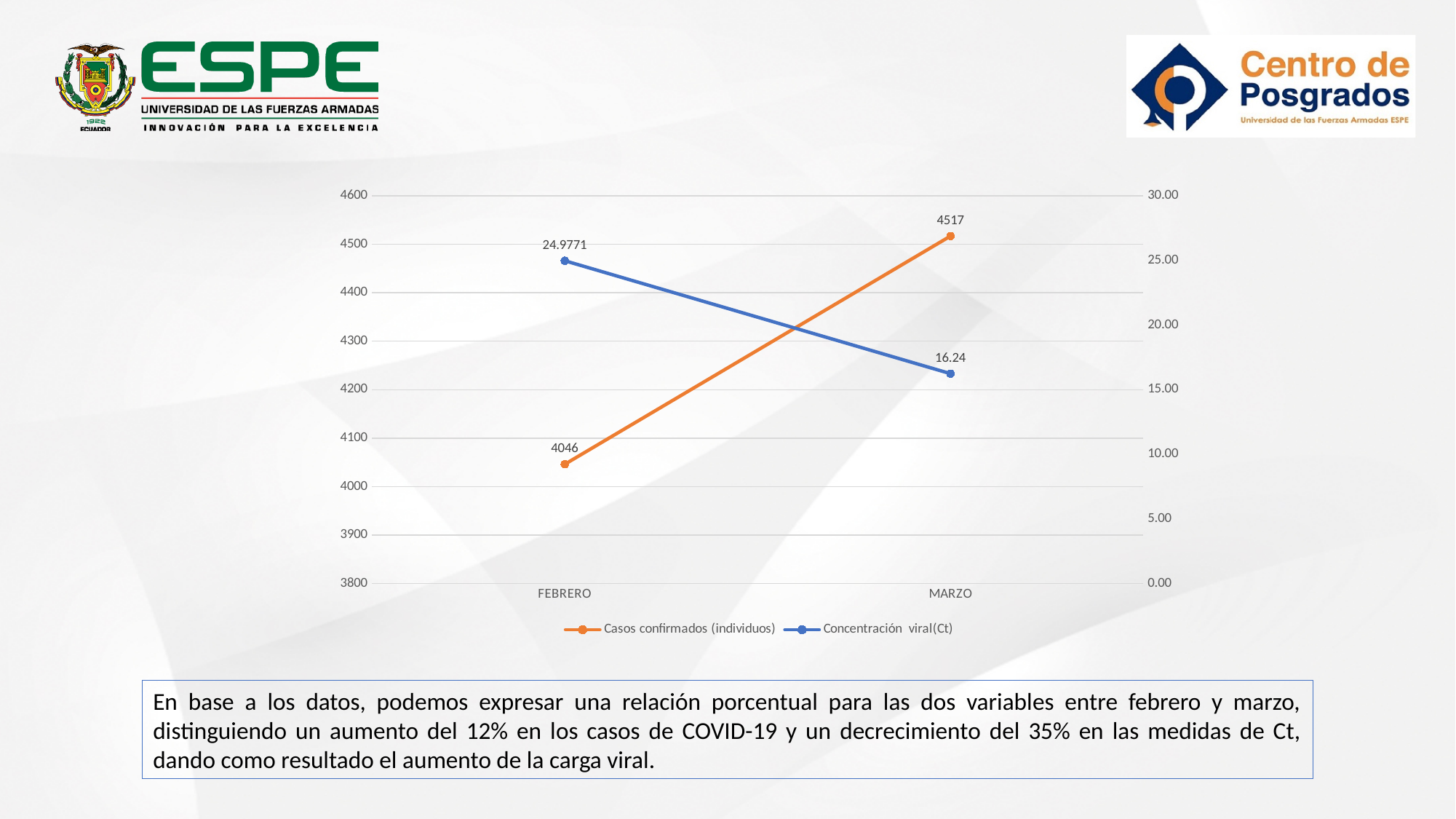
What is the value of Casos confirmados (individuos) for MARZO? 4517 Does the Concentración viral(Ct) series rise or fall from FEBRERO to MARZO? fall Is the Concentración viral(Ct) value for FEBRERO greater or less than the value for MARZO? greater What kind of chart is shown on the slide? line chart Which month has the lower value for Concentración viral(Ct)? MARZO What is the value of Casos confirmados (individuos) for FEBRERO? 4046 Which month has the higher value for Casos confirmados (individuos)? MARZO Does the Casos confirmados (individuos) series rise or fall from FEBRERO to MARZO? rise What is the difference in Casos confirmados (individuos) between MARZO and FEBRERO? 471 What is the value of Concentración viral(Ct) for FEBRERO? 24.9771 What is the value of Concentración viral(Ct) for MARZO? 16.24 How many series does the legend list? 2